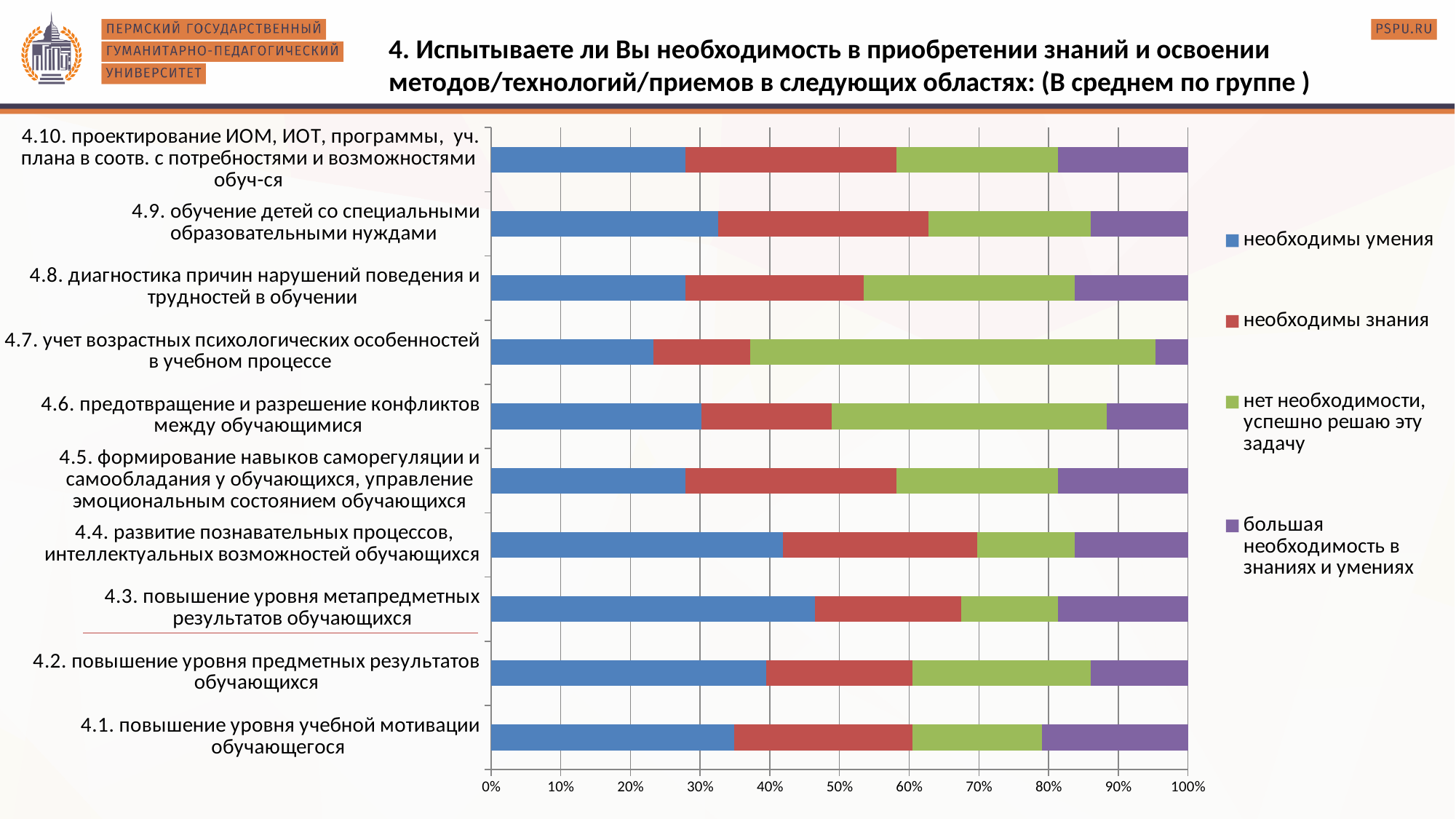
Which has the larger 'необходимы умения' (blue) segment: 4.3 or 4.1? 4.3 Which category has the largest 'необходимы умения' (blue) segment? 4.3. повышение уровня метапредметных результатов обучающихся What kind of chart is shown on the slide? stacked bar chart Is the 'необходимы умения' (blue) value for 4.7 greater or less than 30%? less Which category has the largest 'нет необходимости, успешно решаю эту задачу' (green) segment? 4.7. учет возрастных психологических особенностей в учебном процессе Which category has the smallest 'необходимы умения' (blue) segment? 4.7. учет возрастных психологических особенностей в учебном процессе Which category has the smallest 'большая необходимость в знаниях и умениях' (purple) segment? 4.7. учет возрастных психологических особенностей в учебном процессе Which legend entry is shown in green? нет необходимости, успешно решаю эту задачу How many series does the legend list? 4 Which legend entry is shown in blue? необходимы умения Is the 'необходимы умения' (blue) value for 4.3 greater or less than 40%? greater How many categories (question items) are plotted on the chart? 10